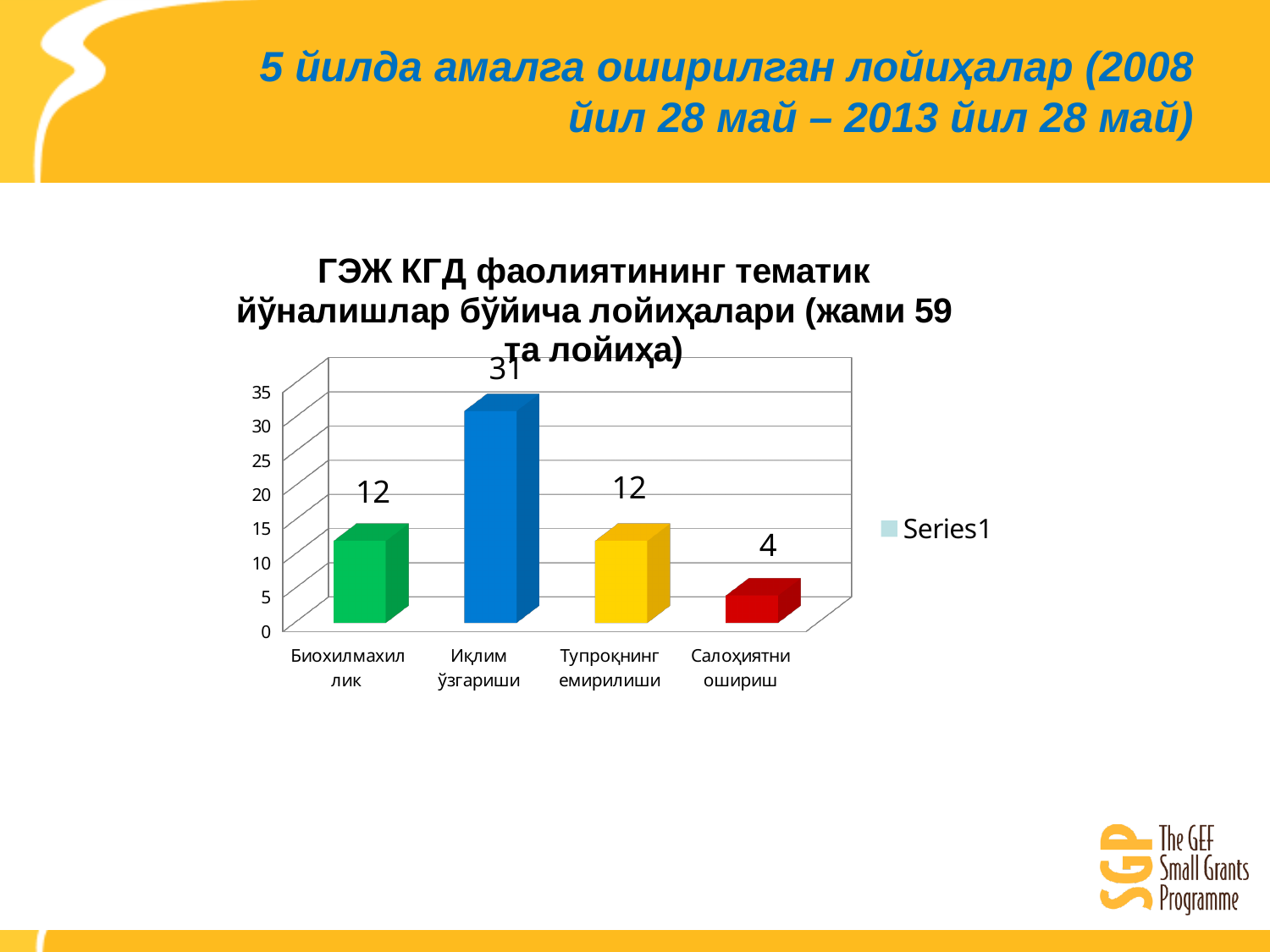
What is the difference between the values for Иқлим ўзгариши and Тупроқнинг емирилиши? 19 Is the value for Иқлим ўзгариши greater or less than 25? greater What is the value for Биохилмахиллик? 12 What kind of chart is shown on the slide? bar chart What is the value for Салоҳиятни ошириш? 4 Which category has the highest value? Иқлим ўзгариши What is the name of the series listed in the legend? Series1 Which category has the lowest value? Салоҳиятни ошириш Which is larger, the value for Биохилмахиллик or the value for Салоҳиятни ошириш? Биохилмахиллик How many series does the legend list? 1 What is the value for Иқлим ўзгариши? 31 How many categories are shown on the x axis? 4